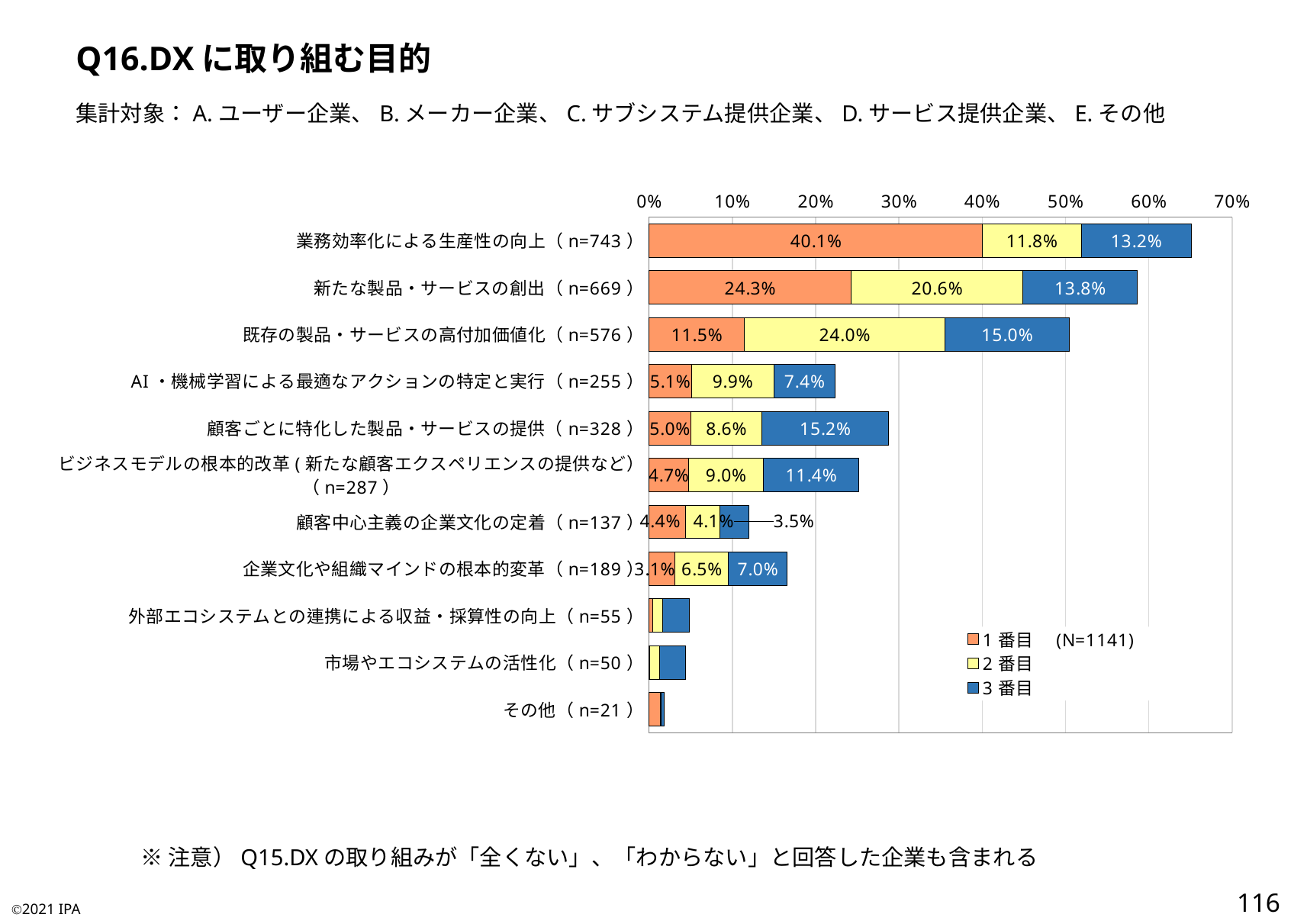
What is the 1番目 value for 業務効率化による生産性の向上? 40.1% Which has the larger 3番目 value: 顧客ごとに特化した製品・サービスの提供 or AI・機械学習による最適なアクションの特定と実行? 顧客ごとに特化した製品・サービスの提供 Is the total stacked bar for 業務効率化による生産性の向上 greater or less than 60%? greater What is the total of the stacked bar for 業務効率化による生産性の向上? 65.1% Which category has the highest 1番目 value? 業務効率化による生産性の向上 What is the 2番目 value for 新たな製品・サービスの創出? 20.6% How much larger is the 2番目 value for 既存の製品・サービスの高付加価値化 than the 2番目 value for 業務効率化による生産性の向上? 12.2 percentage points What is the 3番目 value for 既存の製品・サービスの高付加価値化? 15.0% What is the total of the stacked bar for 新たな製品・サービスの創出? 58.7% What kind of chart is shown on the slide? Stacked bar chart How many series does the legend list? 3 How many categories are shown on the chart? 11